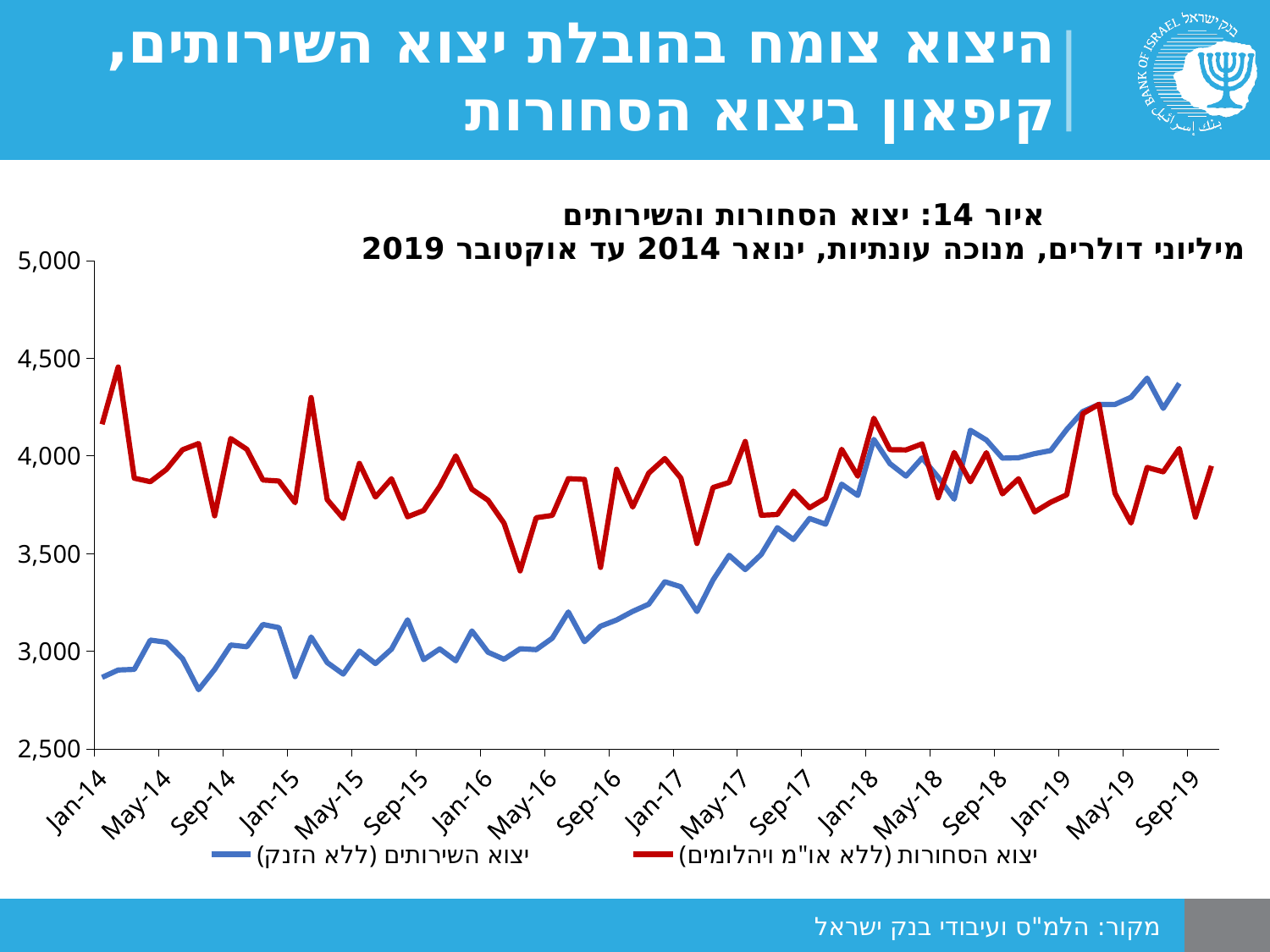
At Jan-16, which series has the higher value, the red line or the blue line? The red line Is the value of יצוא הסחורות (red line) at Jan-14 greater or less than 4,000? greater What kind of chart is shown on the slide? Line chart At Jan-14, which series has the higher value, יצוא הסחורות or יצוא השירותים? יצוא הסחורות Does the blue line (יצוא השירותים) rise or fall overall from Jan-14 to Sep-19? Rise Is the value of יצוא השירותים (blue line) at Jan-14 greater or less than 3,000? less Is the value of יצוא השירותים (blue line) at Jan-17 greater or less than 3,500? less What is the figure number given in the chart title? איור 14 Which series is drawn in blue? יצוא השירותים (ללא הזנק) How many series does the legend list? 2